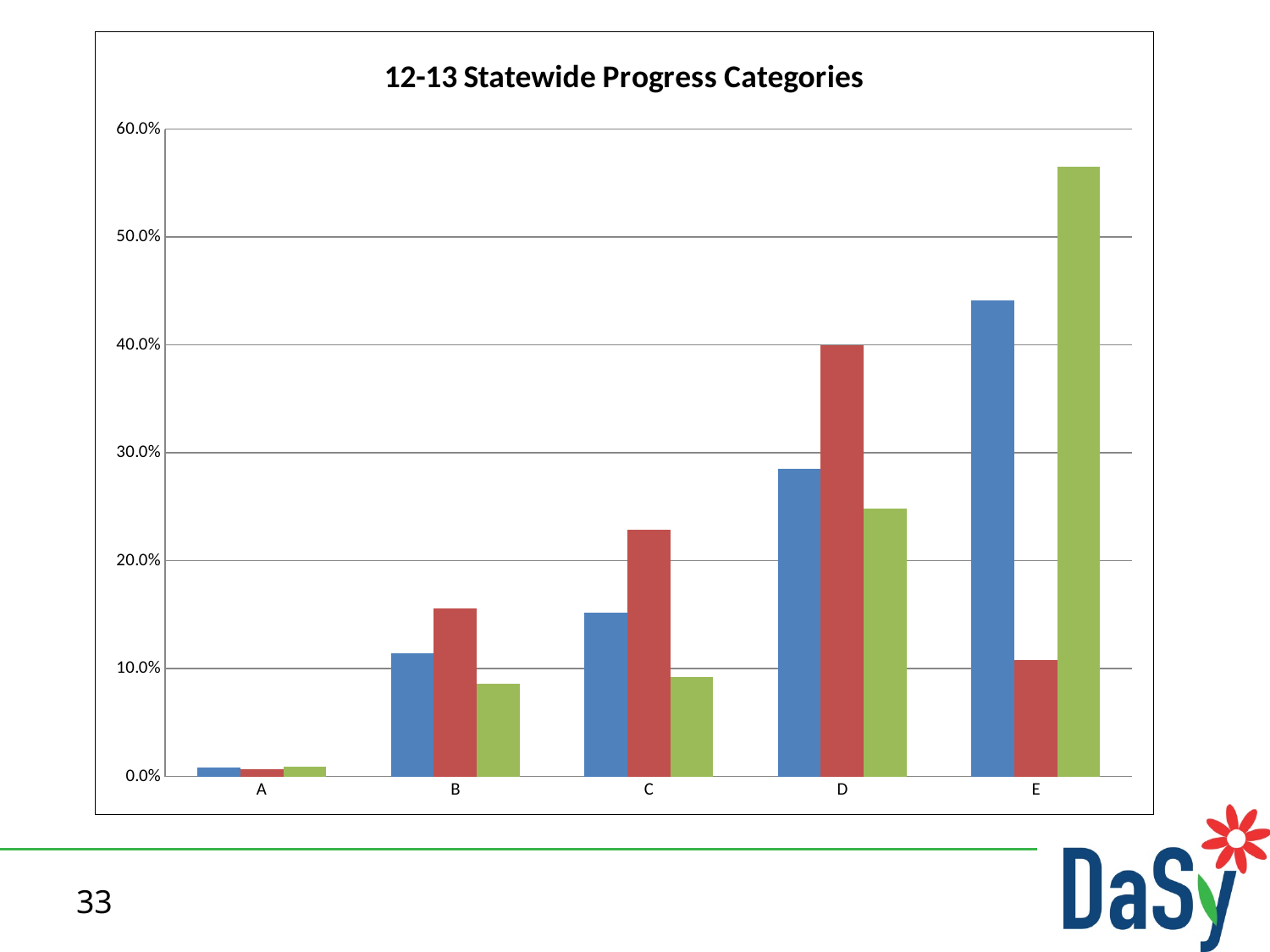
Which category has the shortest blue bar? A Is the red bar for category E greater or less than 20.0%? less Is the green bar for category E greater or less than 50.0%? greater What kind of chart is shown on the slide? bar chart Which category has the tallest red bar? D What is the title of the chart? 12-13 Statewide Progress Categories How many categories are shown on the x axis? 5 Do the blue bars rise or fall from category A to category E? rise How many bars are plotted for each category? 3 In category E, which is larger, the blue bar or the red bar? the blue bar Which category has the tallest blue bar? E Which category has the tallest green bar? E